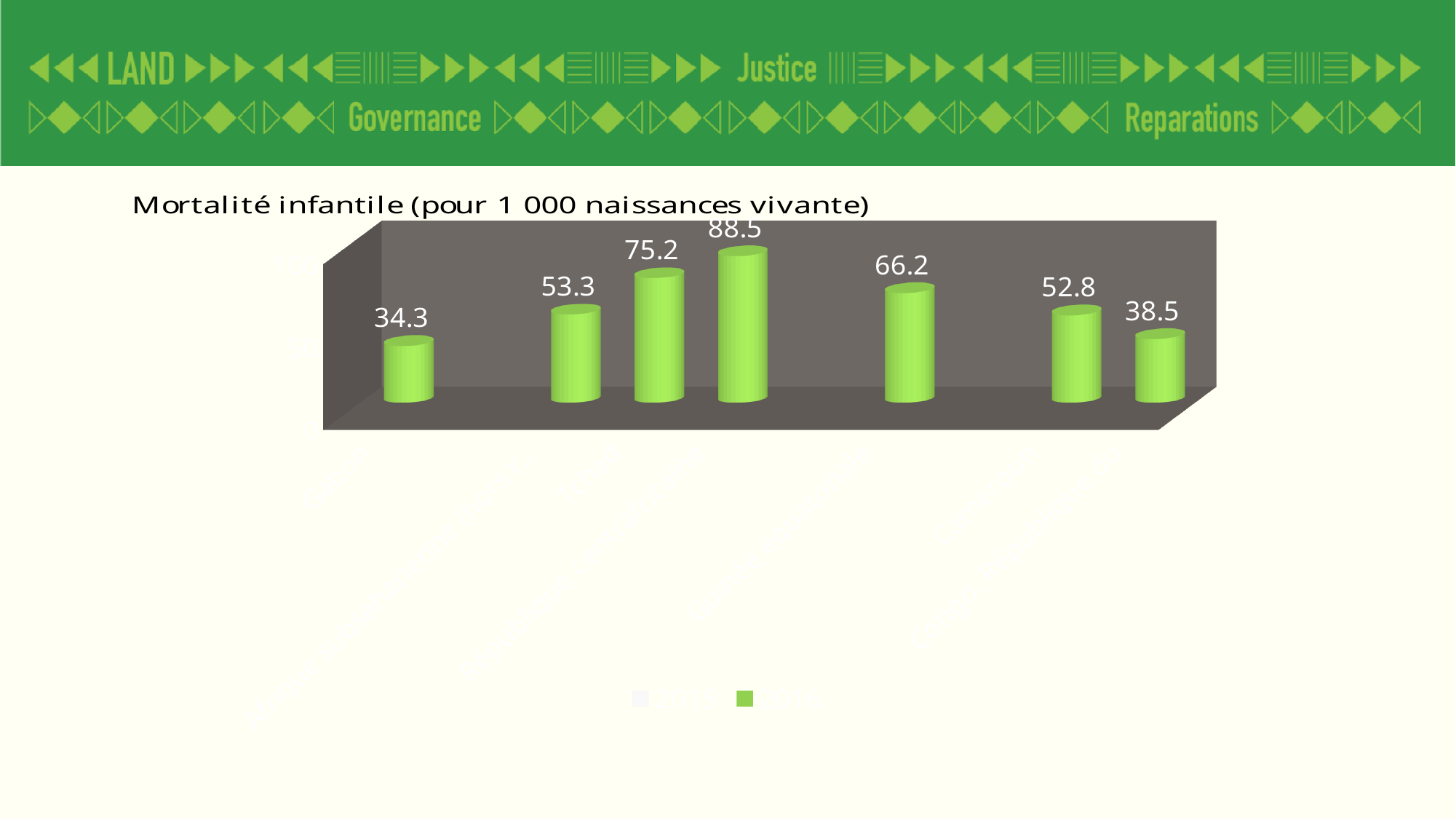
What is the lowest value shown in the chart? 34.3 What is the title of the chart? Mortalité infantile (pour 1 000 naissances vivante) Which is larger, the value of the leftmost bar or the value of the rightmost bar? the rightmost bar (38.5) What is the value of the rightmost bar in the chart? 38.5 What is the difference between the highest and lowest values in the chart? 54.2 What is the value of the fifth bar from the left in the chart? 66.2 What is the value of the second bar from the left in the chart? 53.3 What is the highest value shown in the chart? 88.5 What kind of chart is shown on the slide? bar chart What is the difference between the third bar (75.2) and the fourth bar (88.5) in the chart? 13.3 What is the value of the leftmost bar in the chart? 34.3 How many bars are plotted in the chart? 7